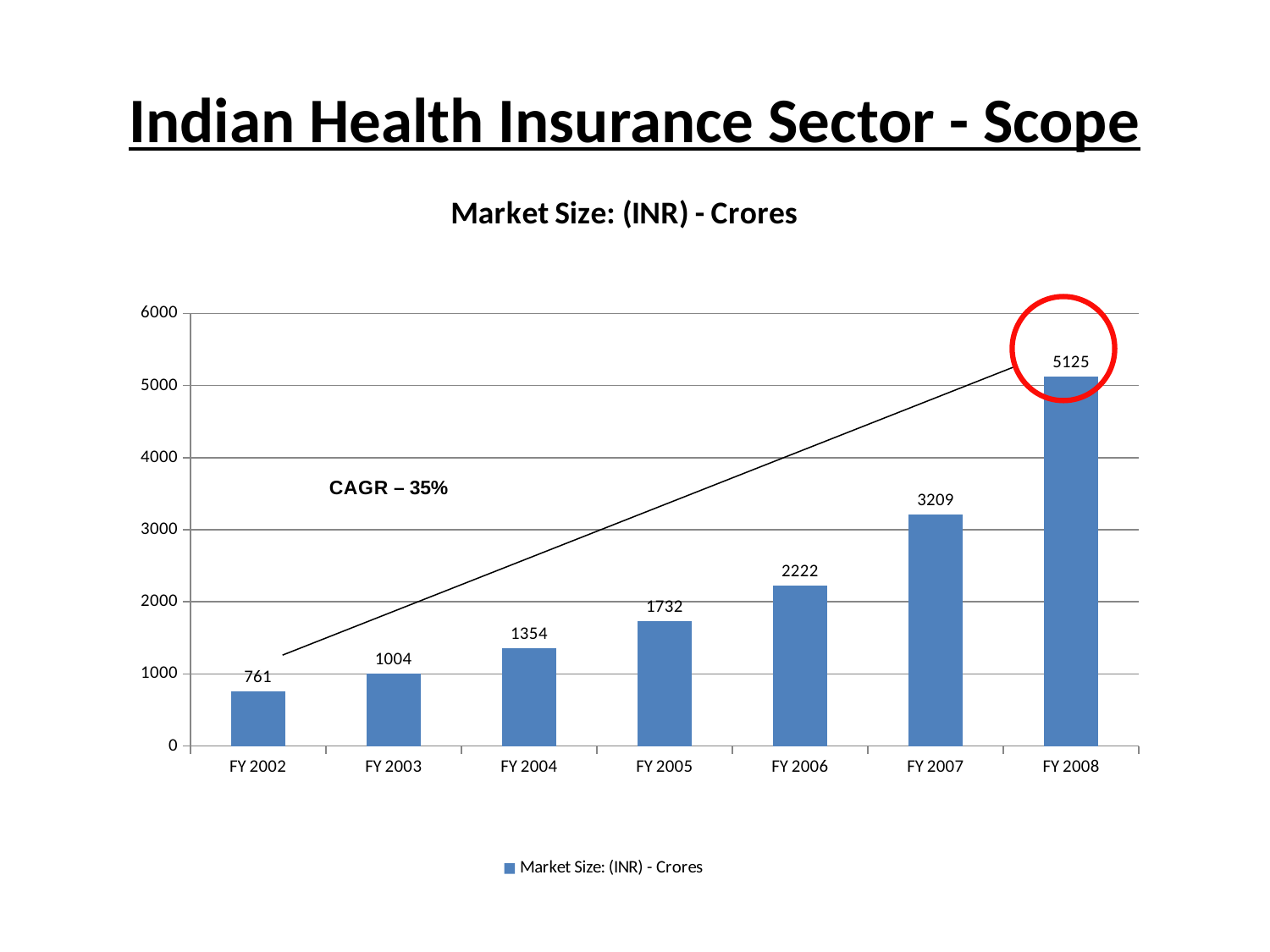
What CAGR is annotated on the chart? 35% What is the difference in market size between FY 2004 and FY 2003? 350 What kind of chart is shown on the slide? Bar chart Do the market size values rise or fall from FY 2002 to FY 2008? Rise Which fiscal year has the highest market size? FY 2008 How many fiscal years are shown on the chart? 7 Which fiscal year has the lowest market size? FY 2002 What is the market size for FY 2005? 1732 What is the market size for FY 2002? 761 What is the market size for FY 2007? 3209 What is the difference in market size between FY 2008 and FY 2007? 1916 Which is larger, the market size for FY 2006 or FY 2005? FY 2006